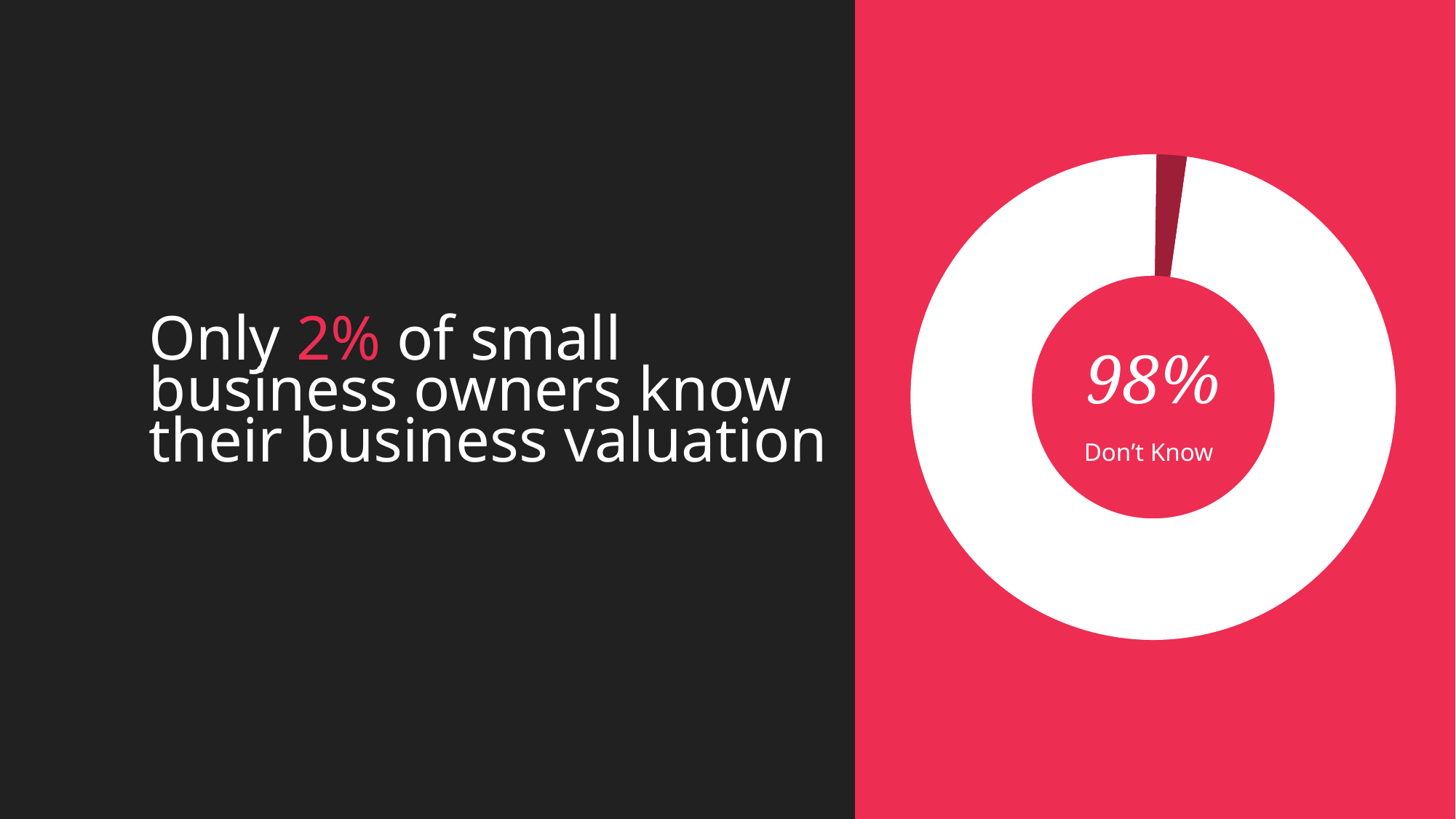
Which slice of the donut chart is larger, the white slice or the dark red slice? The white slice What is the background colour behind the donut chart? Red/pink Which slice of the donut chart is the smallest? The dark red slice (2%) What is the difference between the 'Don't Know' share and the share of owners who know their valuation? 96% What share of the donut chart does the 'Don't Know' slice represent? 98% What kind of chart is shown on the slide? Donut chart According to the slide, what percentage of small business owners know their business valuation? 2% Is the 'Don't Know' share greater or less than 50%? greater How many slices does the donut chart have? 2 What colour is the large 'Don't Know' slice of the donut chart? White What percentage is shown in the centre of the donut chart? 98% What label appears under the 98% in the centre of the donut chart? Don't Know